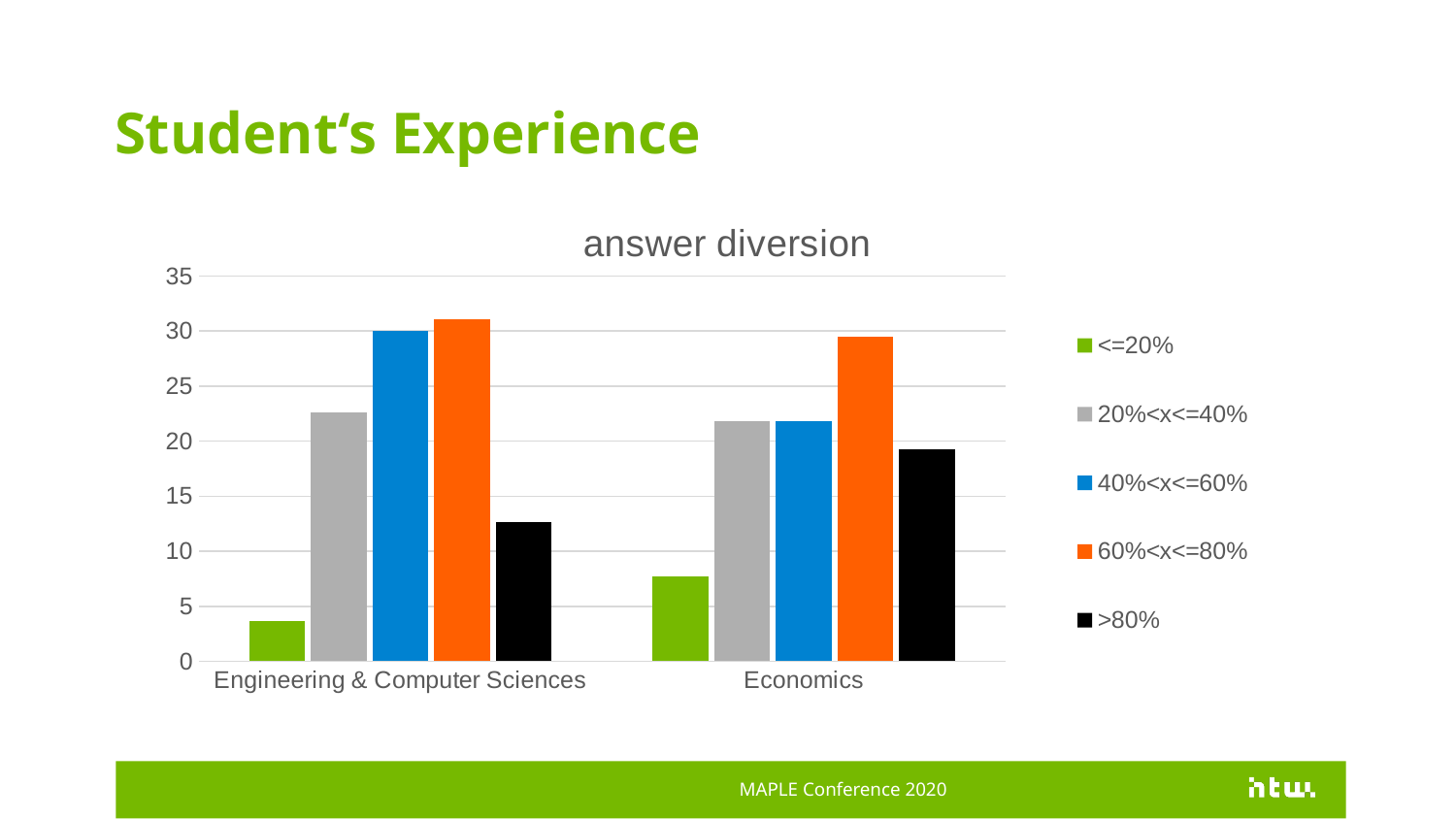
Which series has the lowest value for Engineering & Computer Sciences? <=20% Is the value for <=20% in Economics greater or less than 5? greater What is the title of the chart? answer diversion Is the value for >80% in Economics greater or less than 15? greater Is the value for >80% in Engineering & Computer Sciences greater or less than 15? less How many categories are shown on the x axis? 2 Which series has the lowest value for Economics? <=20% Which series has the highest value for Economics? 60%<x<=80% Which category has the larger value for >80%: Engineering & Computer Sciences or Economics? Economics What kind of chart is shown on the slide? bar chart How many series does the legend list? 5 Which colour represents the >80% series in the legend? black